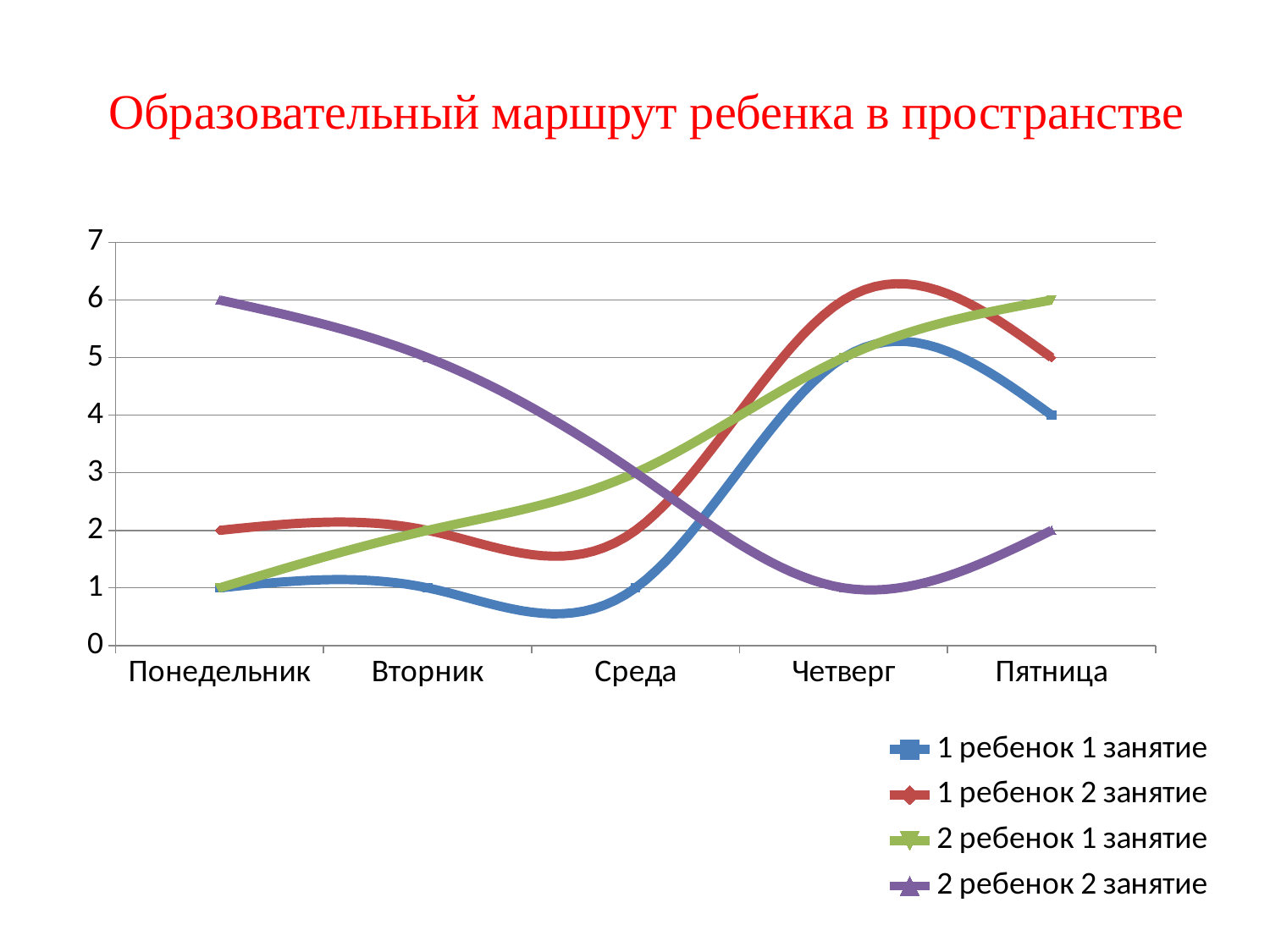
What is the value for "2 ребенок 2 занятие" on Понедельник? 6 What is the value for "2 ребенок 1 занятие" on Пятница? 6 How many categories are shown on the x axis? 5 Is the value for "1 ребенок 2 занятие" on Четверг greater or less than 5? greater Which series has the lowest value on Четверг? 2 ребенок 2 занятие What is the value for "1 ребенок 2 занятие" on Пятница? 5 What kind of chart is shown on the slide? line chart What is the value for "1 ребенок 1 занятие" on Пятница? 4 How many series does the legend list? 4 What is the difference between "2 ребенок 2 занятие" and "1 ребенок 2 занятие" on Понедельник? 4 Which series has the highest value on Понедельник? 2 ребенок 2 занятие Does the value for "2 ребенок 1 занятие" rise or fall from Понедельник to Пятница? rise